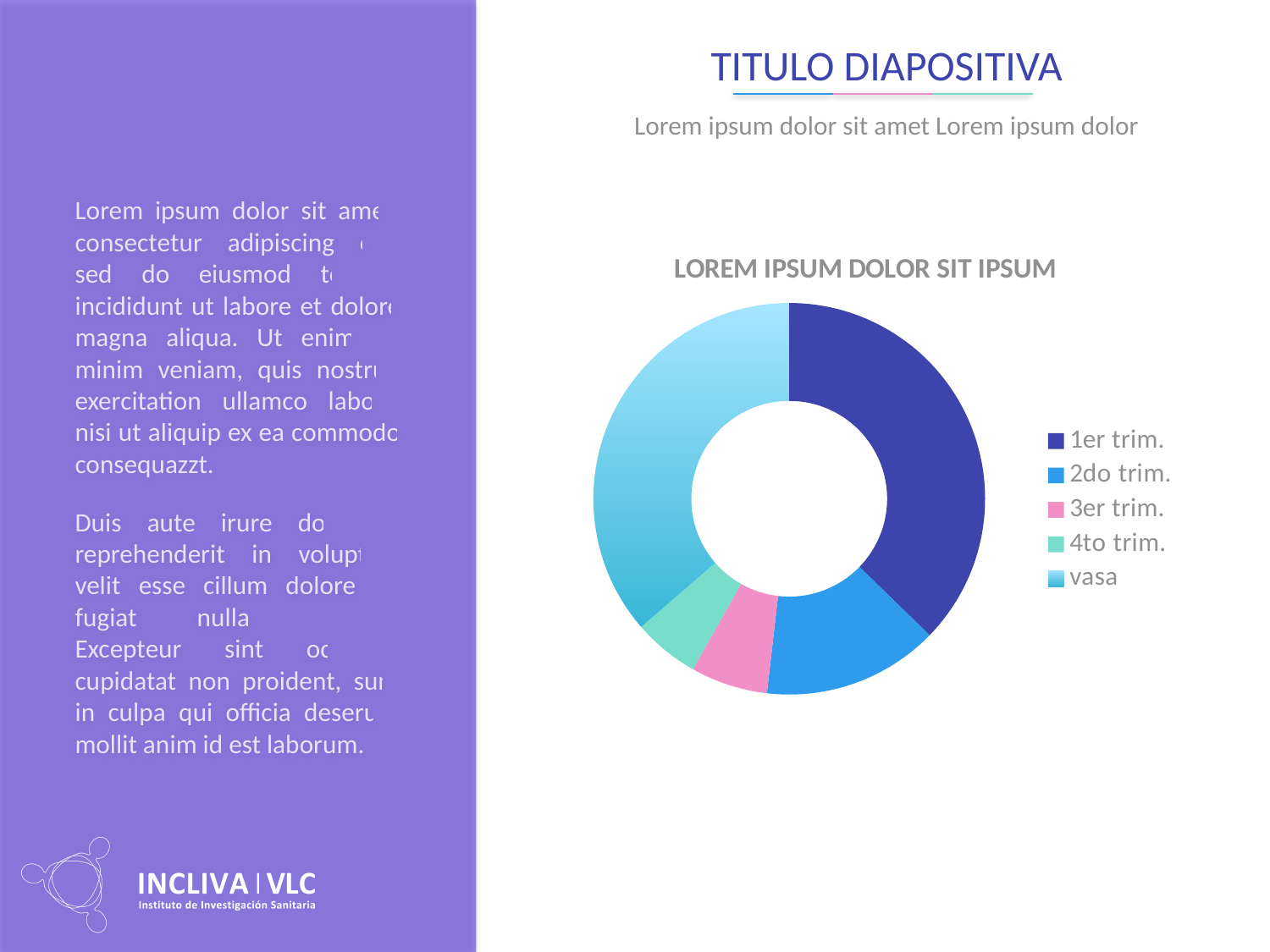
Which slice is larger, 1er trim. or 4to trim.? 1er trim. What is the title of the chart? LOREM IPSUM DOLOR SIT IPSUM How many slices does the doughnut chart have? 5 What colour is the 3er trim. slice in the chart? Pink Which slice is larger, vasa or 4to trim.? vasa What kind of chart is shown on the slide? Doughnut (pie) chart How many entries does the chart legend list? 5 Which slice is larger, 2do trim. or 3er trim.? 2do trim.